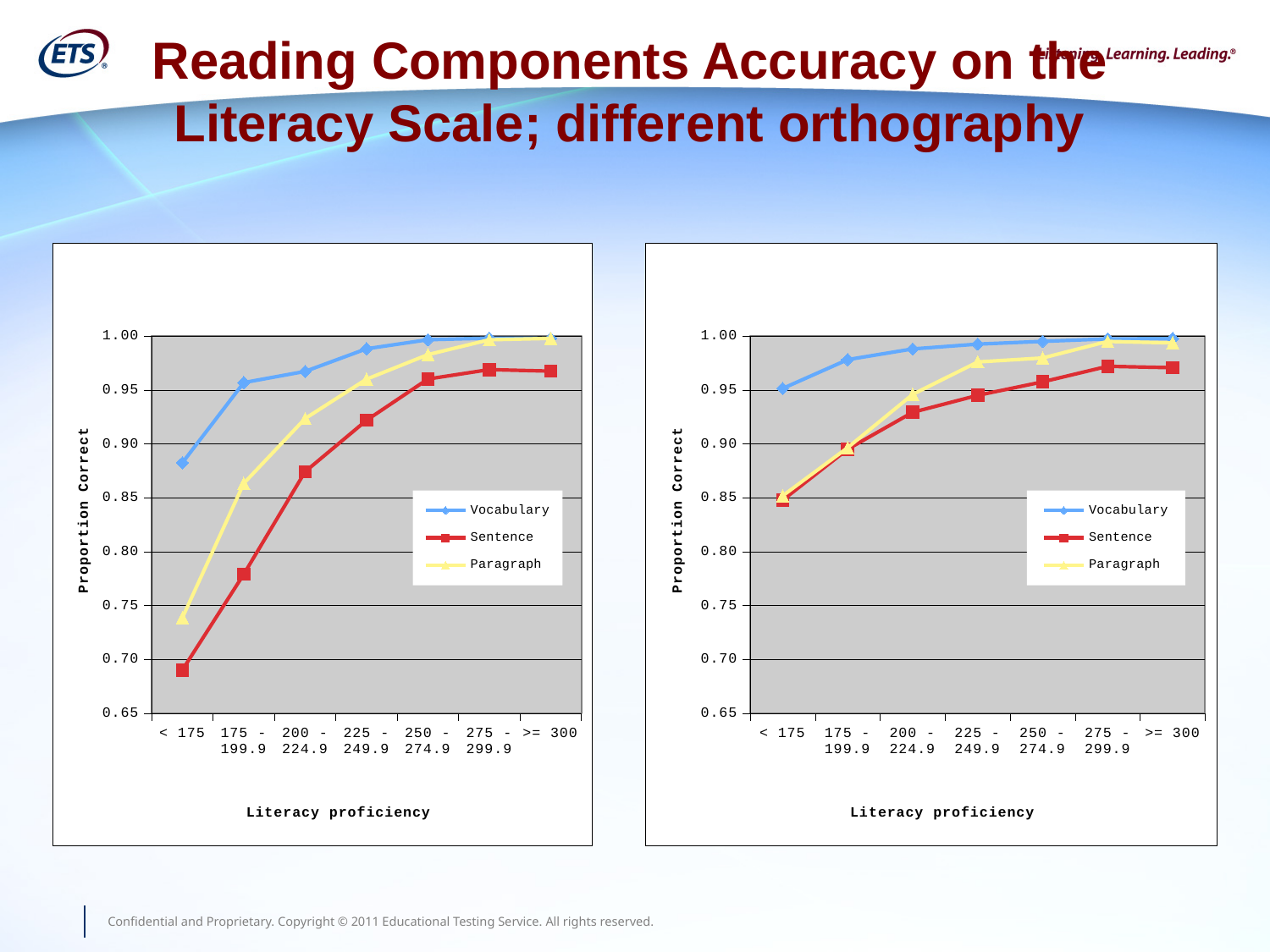
In the left chart, is the value for Vocabulary at < 175 greater or less than 0.90? less In the right chart, is the value for Paragraph at 225 - 249.9 greater or less than 0.95? greater How many series does the legend of the right chart list? 3 How many literacy proficiency categories are shown on the x axis of the left chart? 7 In the left chart, is the value for Sentence at 175 - 199.9 greater or less than 0.80? less In the left chart, which series has the lowest proportion correct at < 175? Sentence What kind of chart is the left chart? line chart In the left chart, does the Sentence series rise or fall as literacy proficiency increases from < 175 to 275 - 299.9? rise What is the y-axis label of the right chart? Proportion Correct In the left chart, which series has the highest proportion correct at 175 - 199.9? Vocabulary In the left chart, which is larger at 200 - 224.9: Paragraph or Sentence? Paragraph